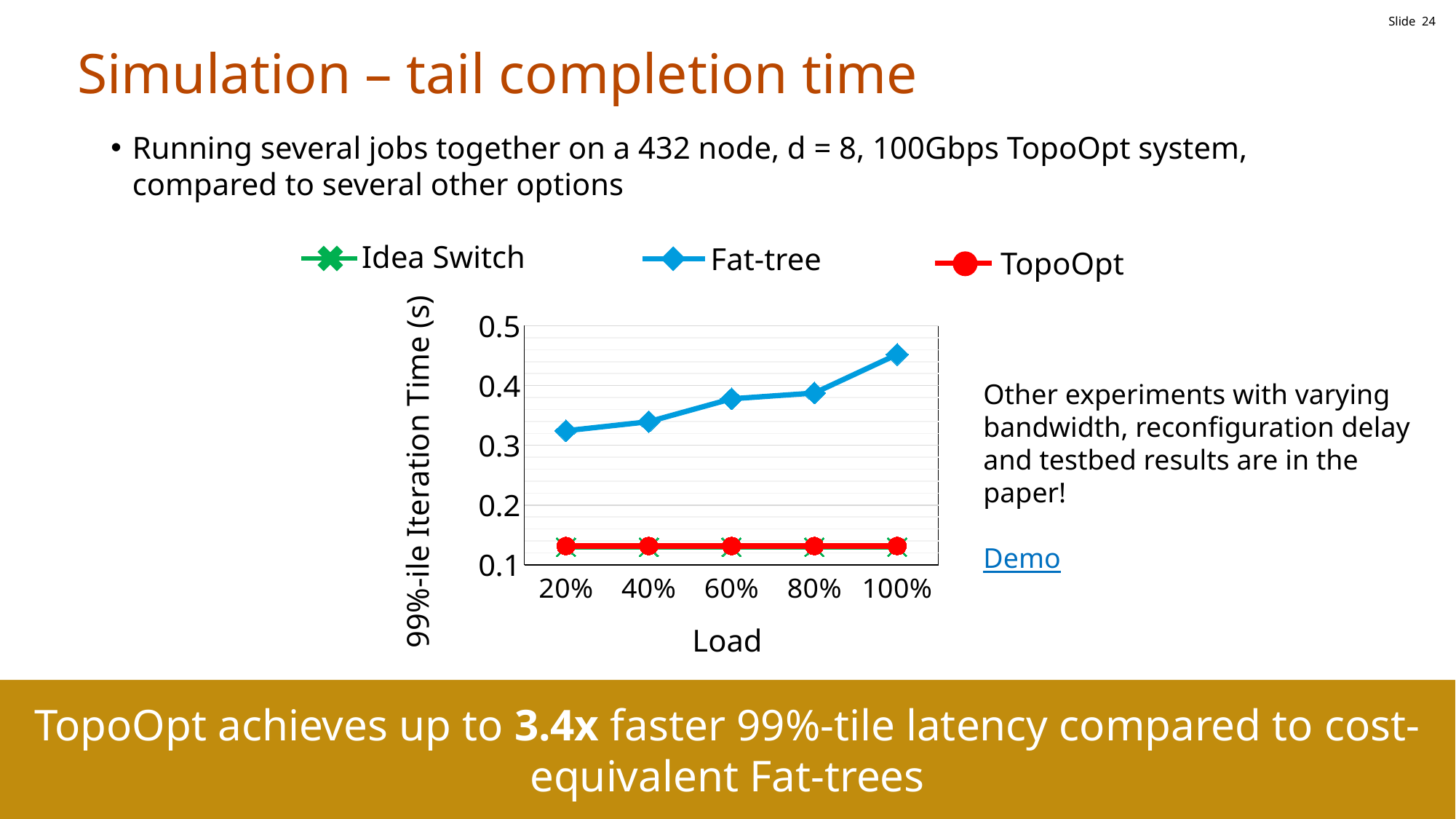
At 80% load, which is larger: the Fat-tree value or the TopoOpt value? Fat-tree How many load levels are plotted along the x axis? 5 Is the TopoOpt value at 60% load greater or less than 0.2? less How many series does the legend list? 3 Is the Fat-tree value at 60% load greater or less than 0.3? greater Does the Fat-tree series rise or fall as load increases from 20% to 100%? rise Which series is drawn in red? TopoOpt Which series has the highest 99%-ile iteration time at 100% load? Fat-tree Is the Fat-tree value at 100% load greater or less than 0.4? greater What is the label of the y axis? 99%-ile Iteration Time (s) What kind of chart is shown on the slide? line chart